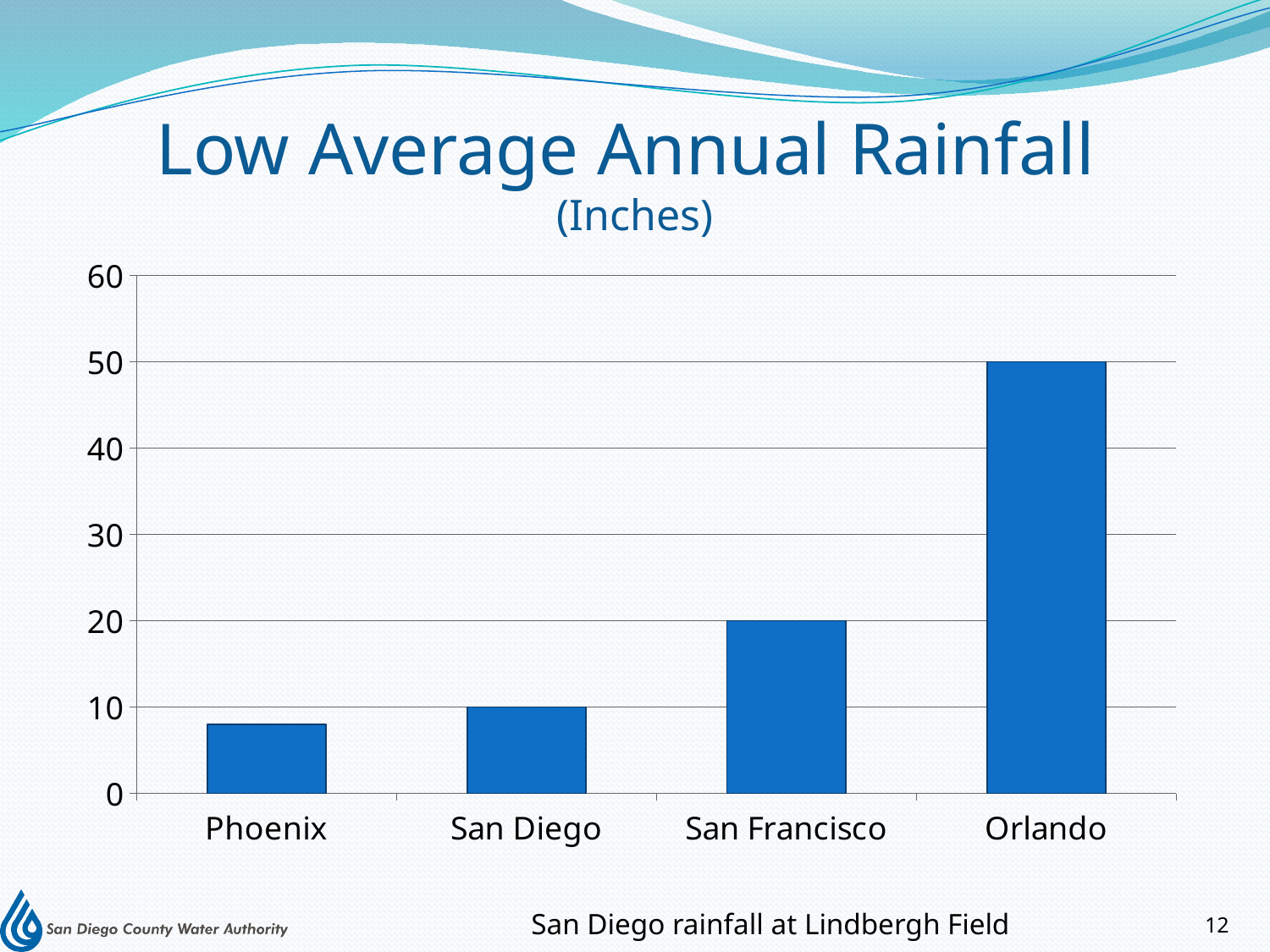
Do the rainfall values rise or fall from Phoenix to Orlando along the x axis? rise What is the difference between the rainfall values for San Francisco and San Diego? 10 Is the value for Phoenix greater or less than 10? less Which city has the lowest average annual rainfall on the chart? Phoenix What is the average annual rainfall shown for San Diego? 10 What is the average annual rainfall shown for San Francisco? 20 What is the average annual rainfall shown for Orlando? 50 How many cities are shown on the chart? 4 How much greater is Orlando's average annual rainfall than San Francisco's? 30 Which city has the highest average annual rainfall on the chart? Orlando Which has the larger average annual rainfall, San Francisco or San Diego? San Francisco What kind of chart is shown on the slide? bar chart